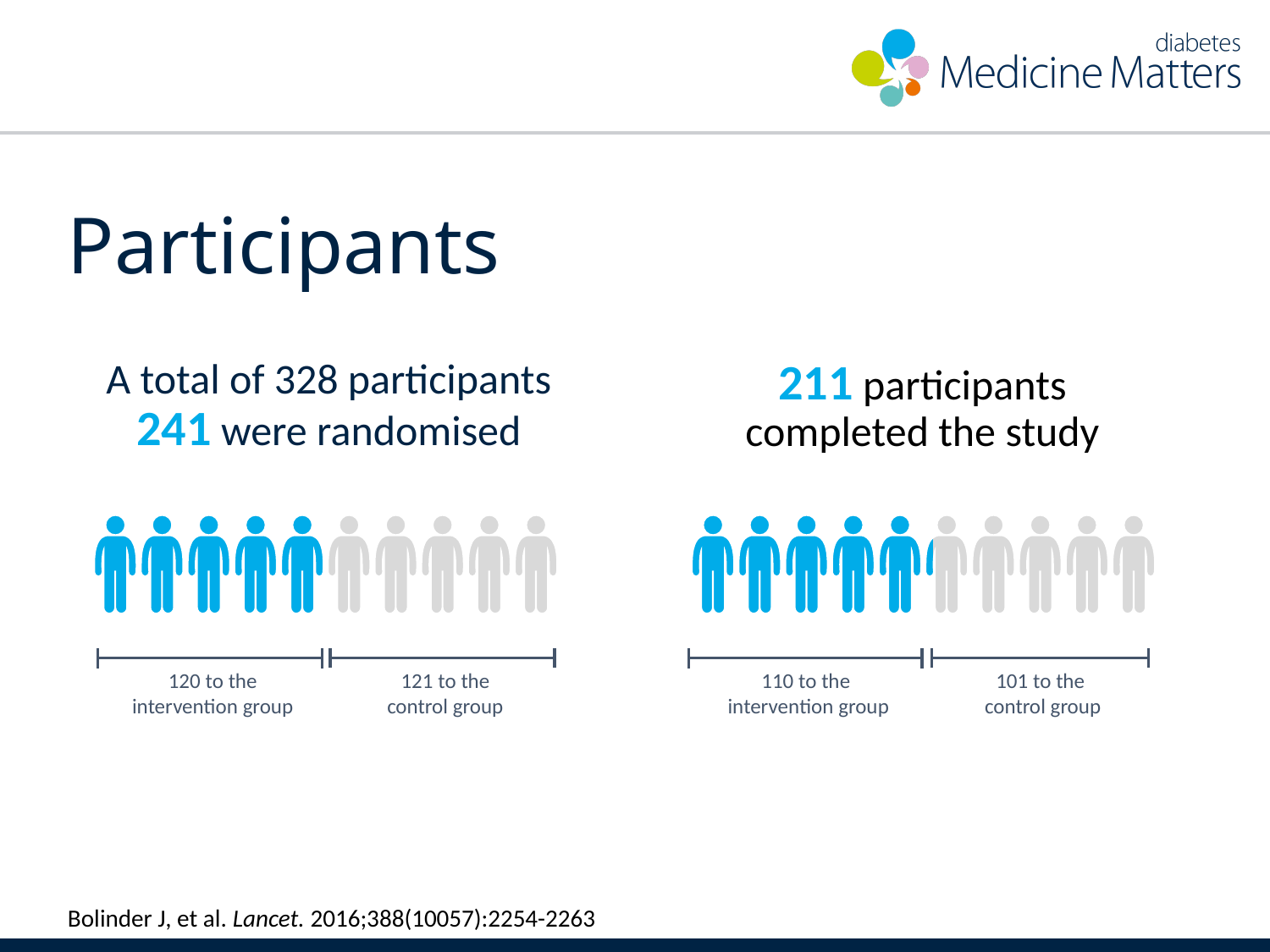
In the right chart, how many participants in the control group completed the study? 101 In the left chart, how many participants were randomised in total? 241 In the right chart, which group had more participants complete the study, the intervention group or the control group? intervention group In the left chart, how many participants were randomised to the intervention group? 120 How many groups are shown in each chart? 2 How many participants were there in total before randomisation, according to the left chart? 328 What is the difference between the number of participants randomised (left chart) and the number who completed the study (right chart)? 30 In the right chart, how many participants completed the study in total? 211 In the right chart, what is the difference between the number of intervention group and control group participants who completed the study? 9 What kind of chart is used on this slide to show the participants? pictograph (icon chart of people figures) In the left chart, how many participants were randomised to the control group? 121 In the right chart, how many participants in the intervention group completed the study? 110